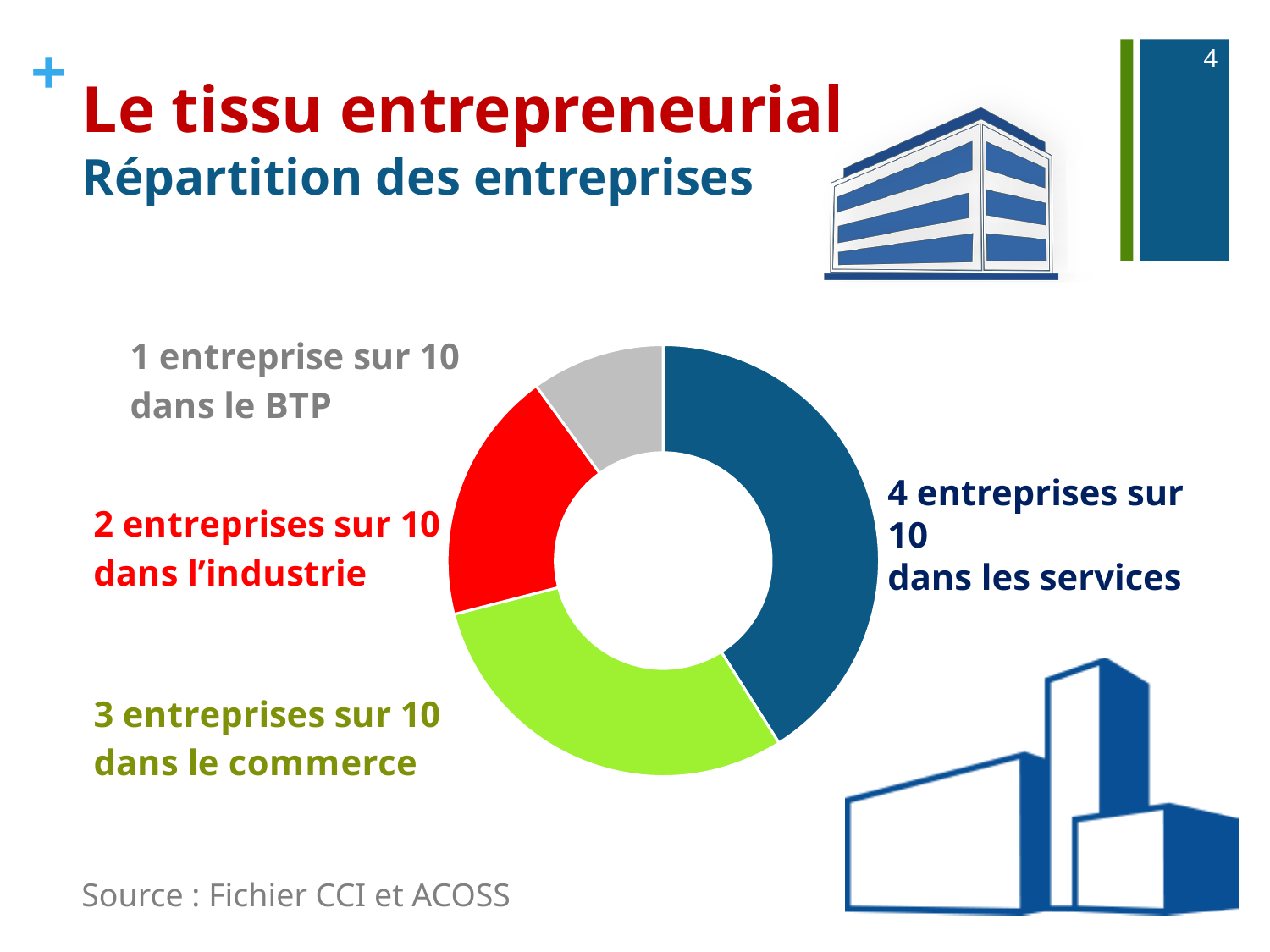
How many enterprises out of 10 are in commerce according to the chart? 3 entreprises sur 10 What kind of chart is shown on the slide? Donut (pie) chart Which sector has more enterprises out of 10: commerce or industrie? Commerce How many enterprises out of 10 are in industry (l'industrie) according to the chart? 2 entreprises sur 10 What colour is the segment representing services in the donut chart? Dark blue How many enterprises out of 10 are in BTP according to the chart? 1 entreprise sur 10 How many enterprises out of 10 are in services according to the chart? 4 entreprises sur 10 What is the difference, in enterprises out of 10, between services and BTP? 3 Which sector has the smallest share of enterprises in the chart? Le BTP What is the source cited for the chart data? Fichier CCI et ACOSS Which sector has the largest share of enterprises in the chart? Les services How many segments does the donut chart have? 4